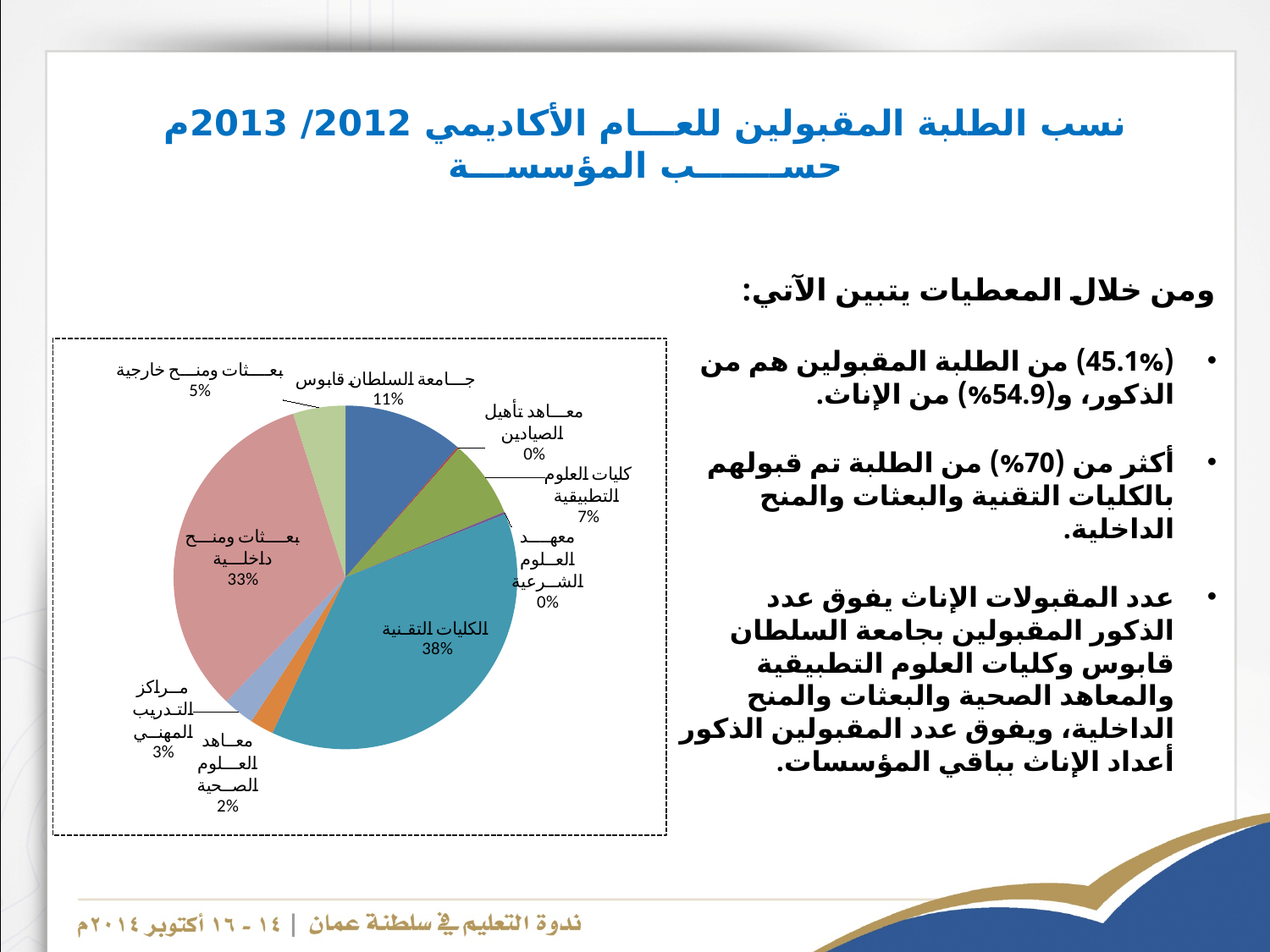
Which institution has the largest share of admitted students? الكليات التقنية What percentage is shown for كليات العلوم التطبيقية? 7% What percentage is shown for جامعة السلطان قابوس? 11% What percentage is shown for بعثات ومنح خارجية? 5% What is the difference in percentage points between الكليات التقنية and بعثات ومنح داخلية? 5% What percentage is shown for معاهد العلوم الصحية? 2% What type of chart is shown on the slide? pie chart What percentage is shown for بعثات ومنح داخلية? 33% What percentage is shown for مراكز التدريب المهني? 3% Which has a larger share, جامعة السلطان قابوس or كليات العلوم التطبيقية? جامعة السلطان قابوس How many institution categories are shown in the pie chart? 9 What percentage of admitted students went to الكليات التقنية? 38%